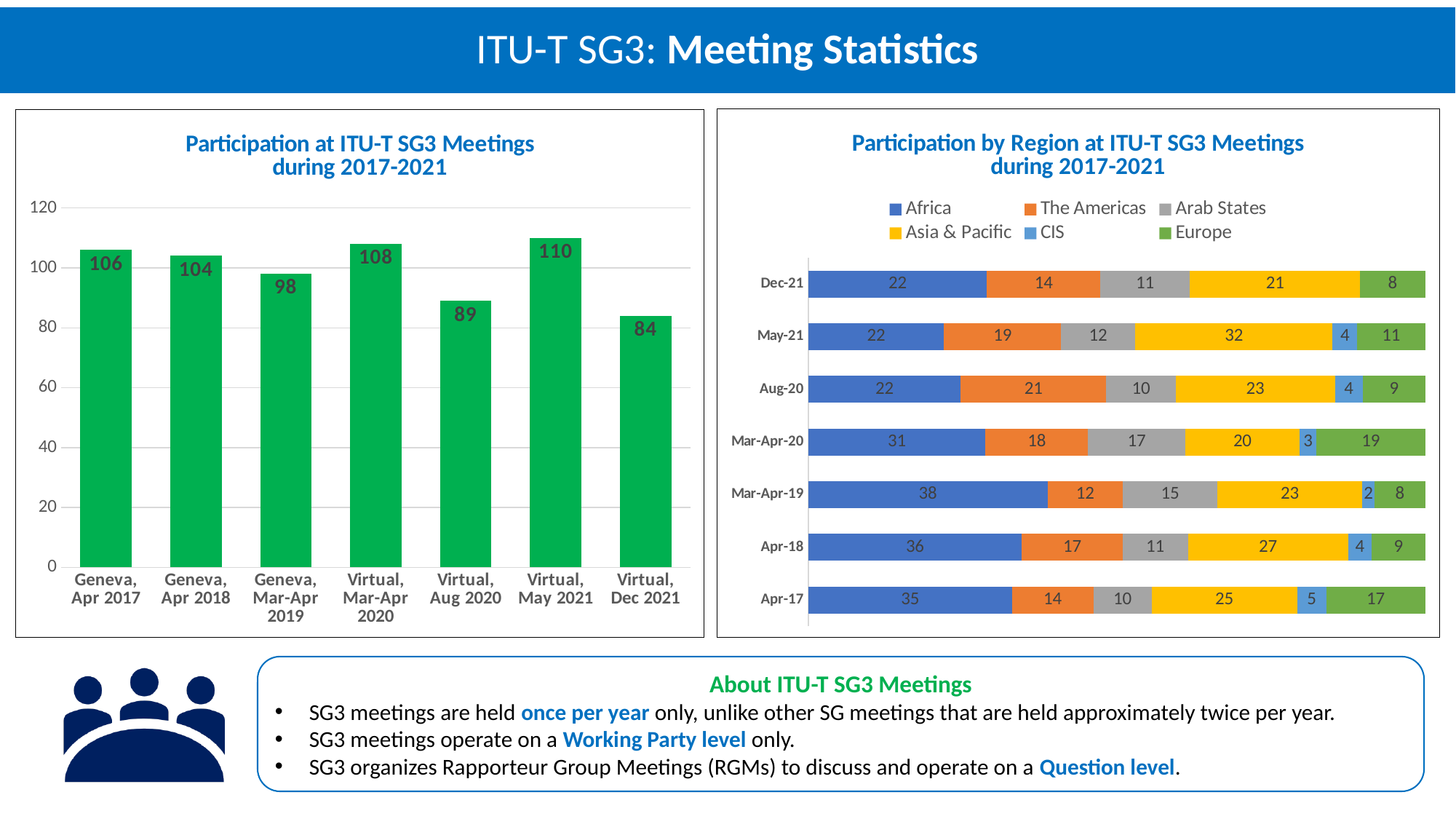
In the 'Participation at ITU-T SG3 Meetings during 2017-2021' chart, what is the value for Virtual, May 2021? 110 In the 'Participation at ITU-T SG3 Meetings during 2017-2021' chart, which meeting has the lowest participation? Virtual, Dec 2021 In the 'Participation at ITU-T SG3 Meetings during 2017-2021' chart, which meeting has the highest participation? Virtual, May 2021 How many meetings are shown in the 'Participation at ITU-T SG3 Meetings during 2017-2021' chart? 7 In the 'Participation by Region at ITU-T SG3 Meetings during 2017-2021' chart, what is the total of the Aug-20 bar? 89 In the 'Participation by Region at ITU-T SG3 Meetings during 2017-2021' chart, what is the CIS value for Apr-17? 5 In the 'Participation at ITU-T SG3 Meetings during 2017-2021' chart, what is the difference between Geneva, Apr 2017 and Virtual, Dec 2021? 22 In the 'Participation by Region at ITU-T SG3 Meetings during 2017-2021' chart, which meeting has the highest Africa value? Mar-Apr-19 In the 'Participation by Region at ITU-T SG3 Meetings during 2017-2021' chart, what is the Asia & Pacific value for May-21? 32 How many series does the legend of the 'Participation by Region at ITU-T SG3 Meetings during 2017-2021' chart list? 6 What kind of chart is the 'Participation at ITU-T SG3 Meetings during 2017-2021' chart? bar chart In the 'Participation by Region at ITU-T SG3 Meetings during 2017-2021' chart, which is larger for Apr-17: Africa or Europe? Africa